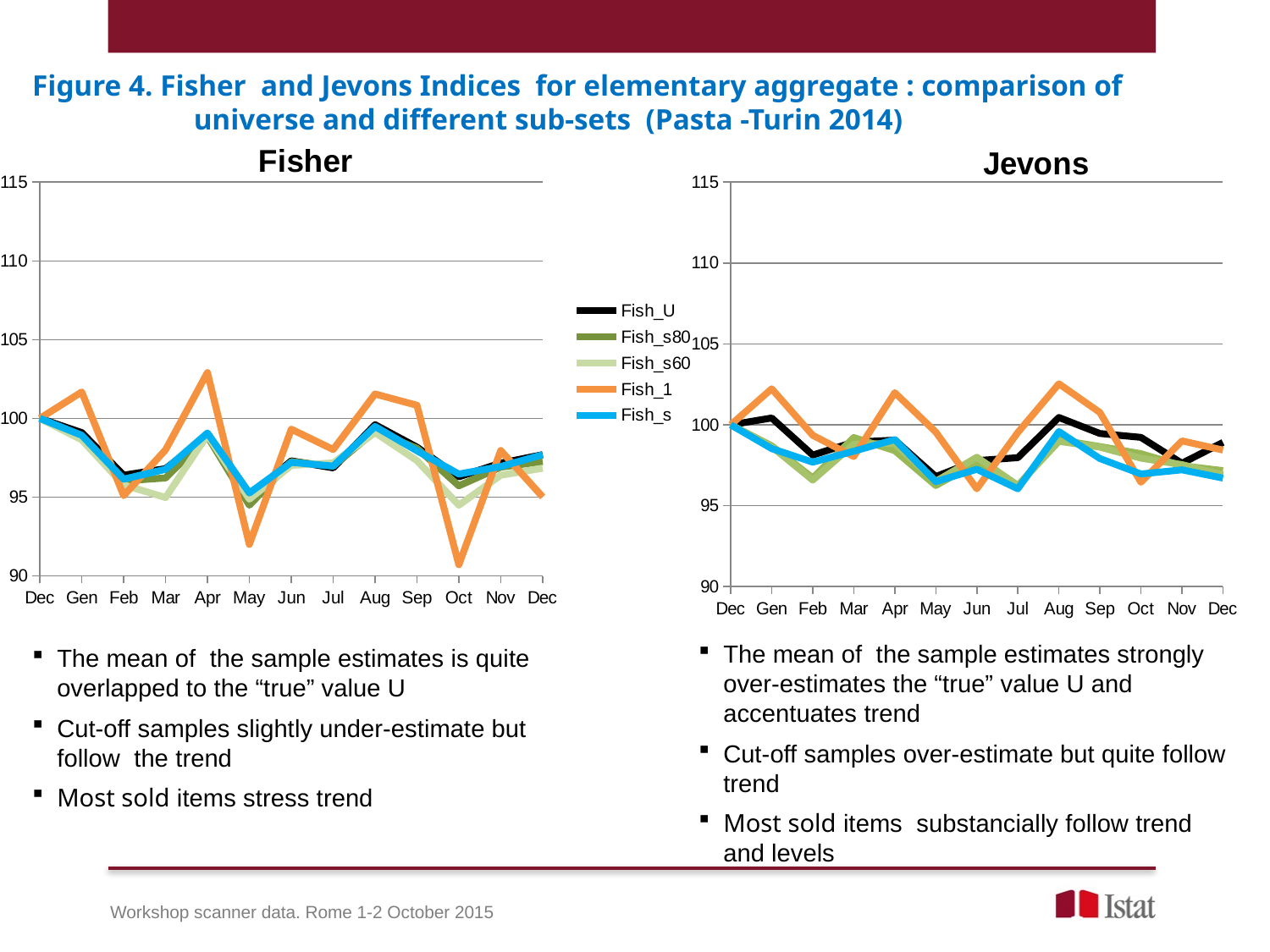
In the Fisher chart, is the value of Fish_1 in Apr greater or less than 100? greater In the Fisher chart, is the value of Fish_1 in Oct greater or less than 95? less In the Fisher chart, which series has the lowest value in Oct? Fish_1 Which series in the legend is drawn in orange? Fish_1 What kind of chart is the Fisher chart on the left? Line chart In the Jevons chart, is the value of Fish_1 in Aug greater or less than 100? greater In the Fisher chart, which series has the highest value in Apr? Fish_1 In the Fisher chart, does the Fish_1 series rise or fall from Sep to Oct? Fall How many series does the legend between the two charts list? 5 How many points are plotted along the x axis of the Jevons chart? 13 In the Fisher chart, which is larger in Apr: Fish_1 or Fish_U? Fish_1